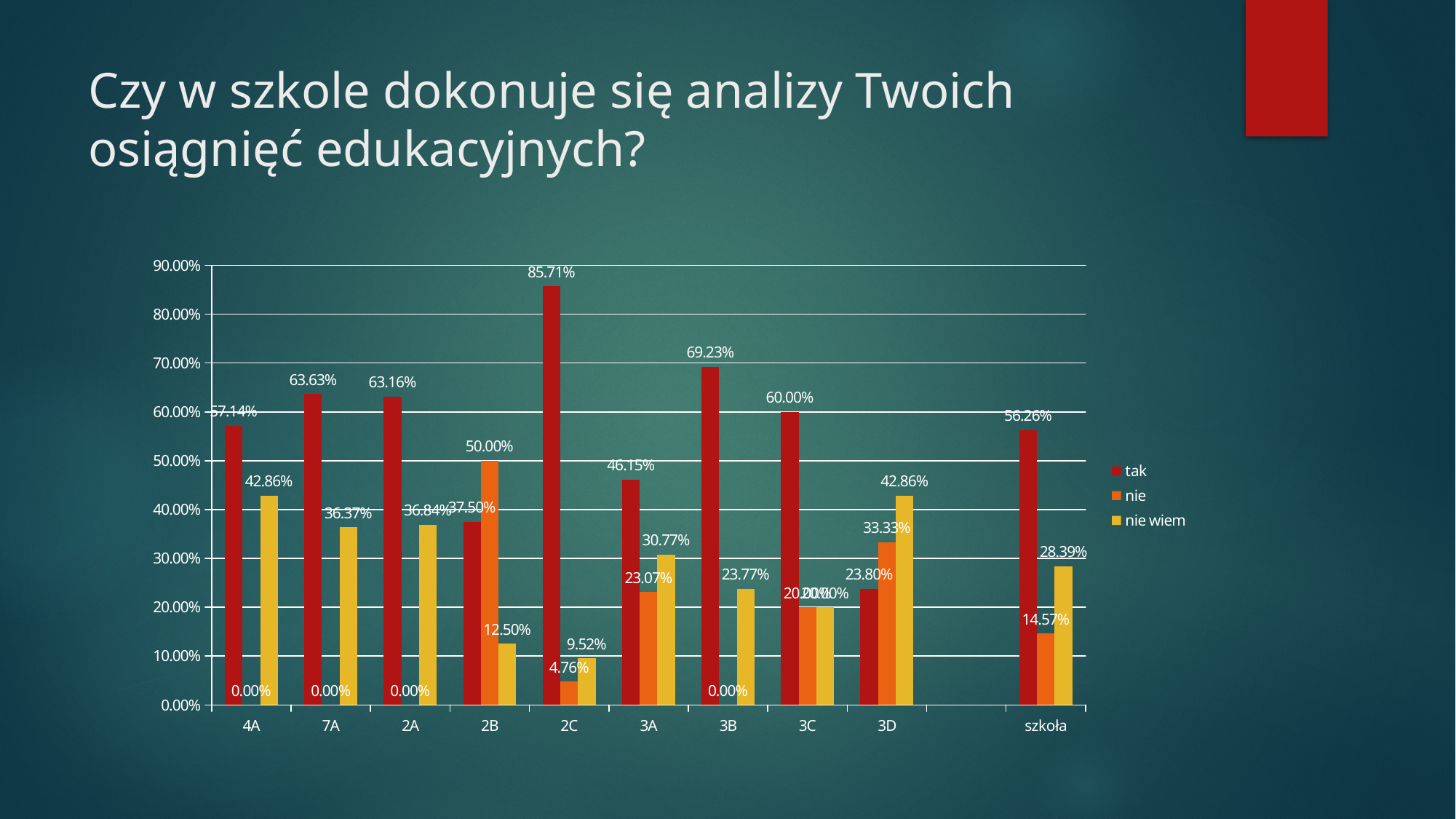
How many series does the legend list? 3 What is the value of 'nie wiem' for class 3D? 42.86% Which is larger for class 2B: the 'tak' value or the 'nie' value? nie What is the value of 'tak' for class 2C? 85.71% What is the value of 'nie' for szkoła? 14.57% How many categories are shown on the x axis? 10 What colour are the bars for the 'nie wiem' series? yellow Which category has the lowest 'tak' value? 3D What is the difference between the 'tak' value for 3B and the 'tak' value for 3A? 23.08% Is the 'tak' value for szkoła greater or less than 50.00%? greater Which category has the highest 'tak' value? 2C What type of chart is shown on the slide? bar chart